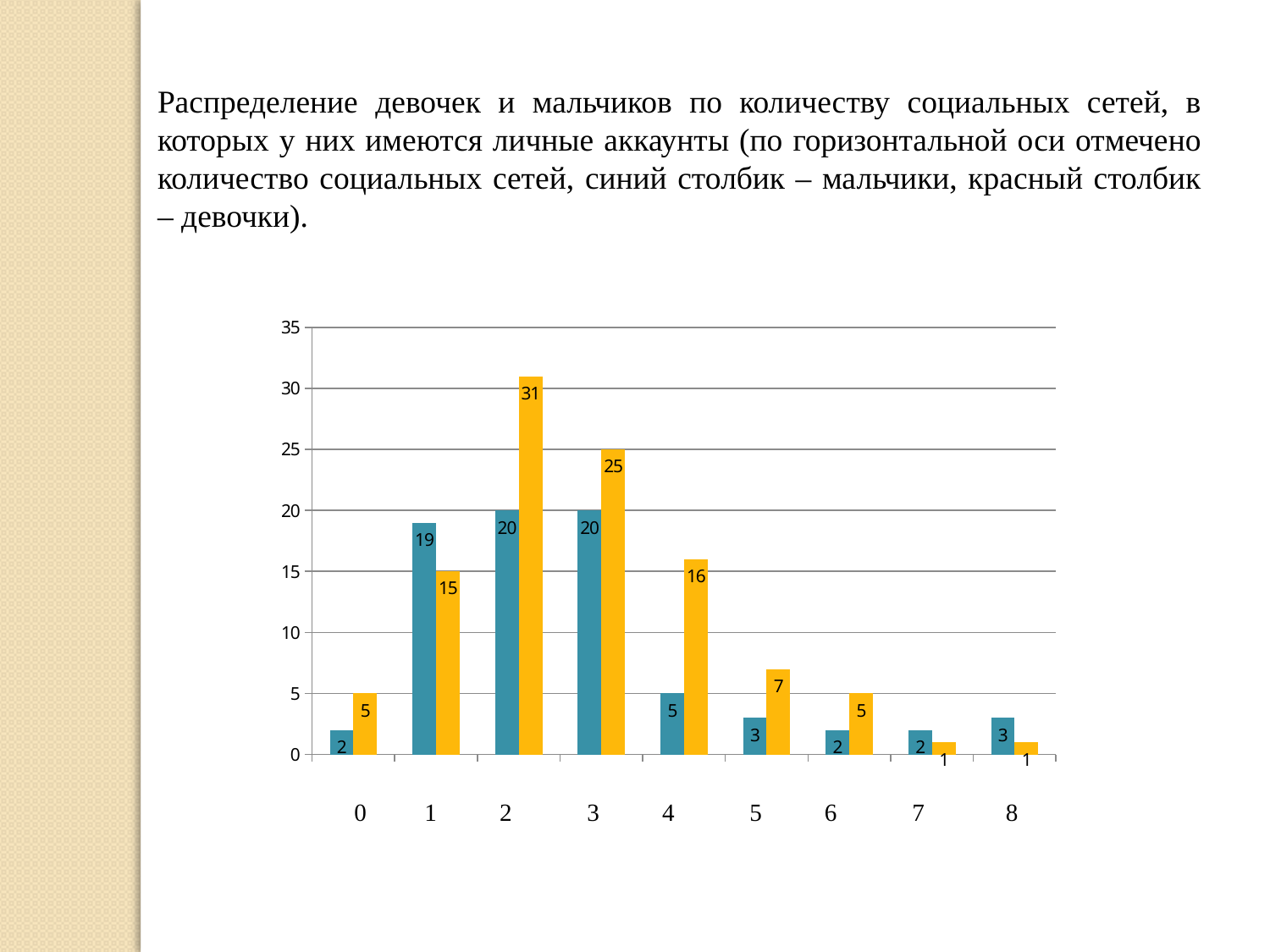
What is the value of the blue bar (boys) for category 8? 3 What type of chart is shown on the slide? bar chart What is the value of the orange bar (girls) for category 2? 31 What is the difference between the orange bar (girls) and the blue bar (boys) for category 2? 11 What is the difference between the orange bar (girls) for category 3 and the orange bar for category 4? 9 How many categories are shown along the horizontal axis? 9 What is the value of the blue bar (boys) for category 1? 19 What is the value of the orange bar (girls) for category 4? 16 For category 1, which bar is larger, the blue (boys) or the orange (girls)? blue (boys) For which category is the orange bar (girls) highest? 2 For which category is the blue bar (boys) lowest? 0, 6 and 7 (all 2) According to the slide text, which group do the blue bars represent? мальчики (boys)